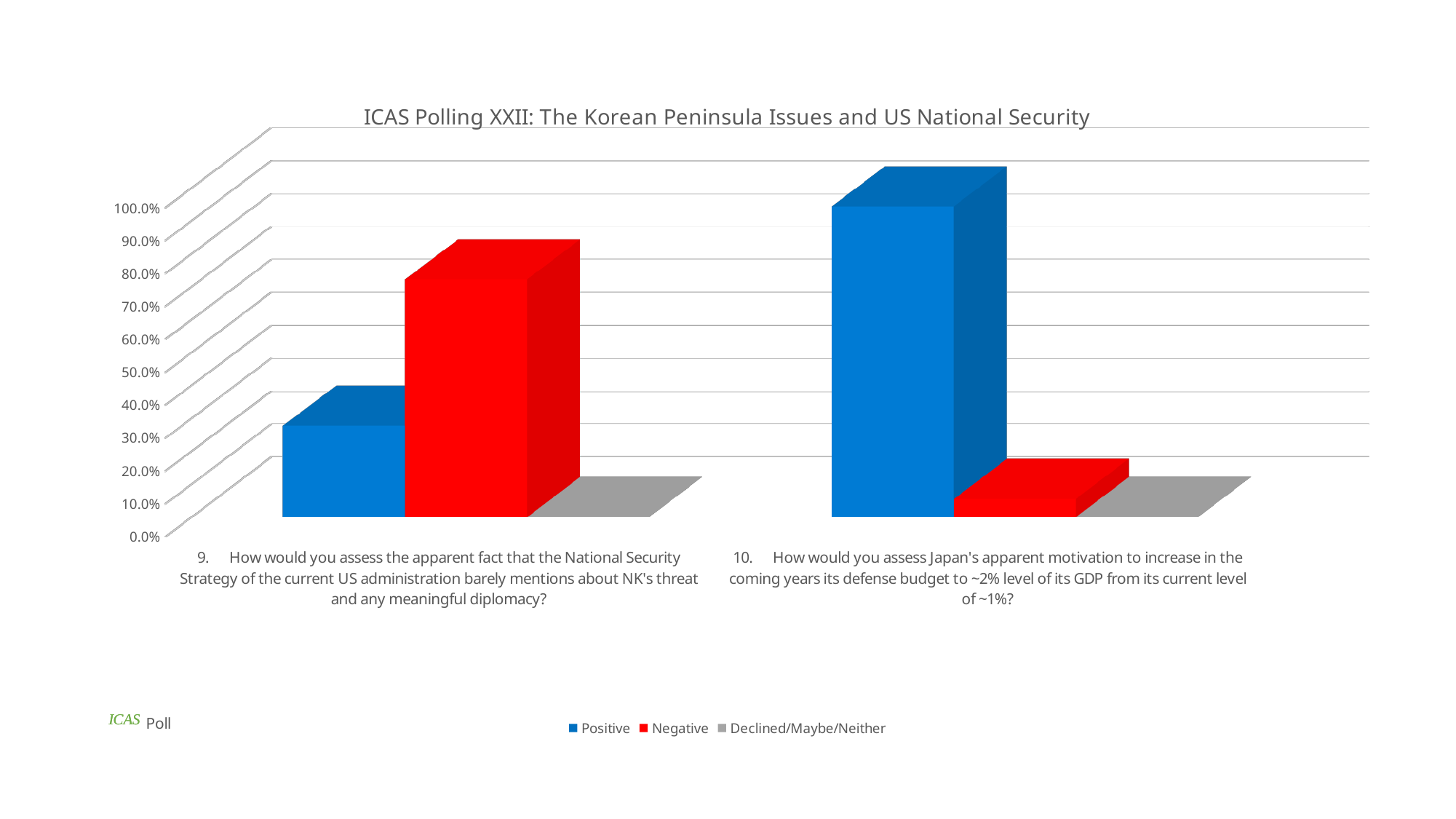
What is the title of the chart? ICAS Polling XXII: The Korean Peninsula Issues and US National Security Is the Positive value for question 9 greater or less than 50.0%? less Is the Negative value for question 10 greater or less than 20.0%? less How many series does the legend list? 3 Which series has the tallest bar anywhere on the chart? Positive Which series is shown in red in the legend? Negative For question 10, which response is larger: Positive or Negative? Positive How many question categories are shown on the x axis? 2 Is the Negative value for question 9 greater or less than 50.0%? greater What kind of chart is shown on the slide? bar chart For question 9, which response is larger: Positive or Negative? Negative